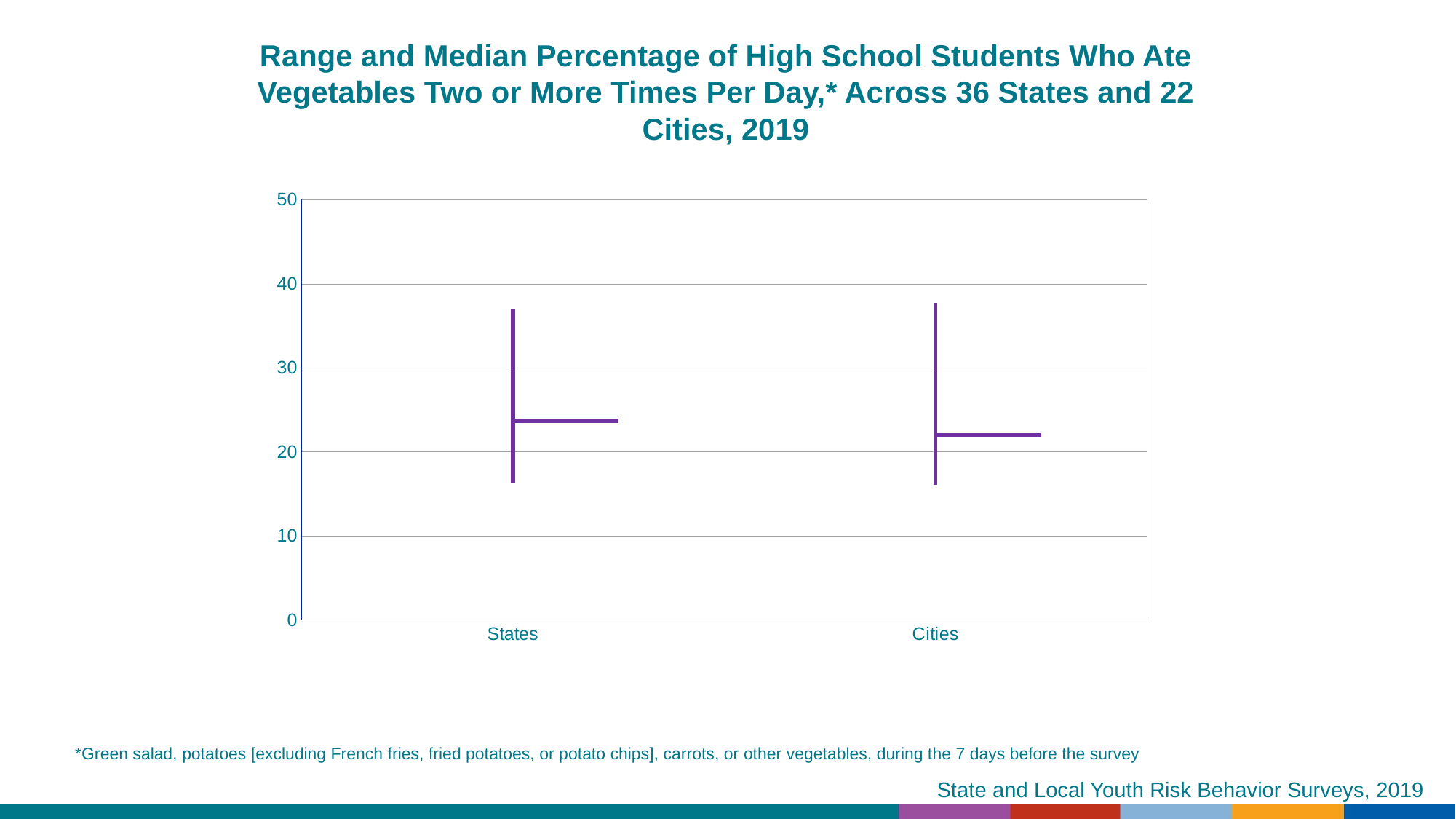
Which has the higher median value, States or Cities? States Is the median value for States greater or less than 30? less Is the top of the range for States greater or less than 30? greater Is the bottom of the range for States greater or less than 20? less What are the two categories shown on the x axis? States and Cities What year does the chart title refer to? 2019 What is the highest value shown on the y axis? 50 How many categories are shown on the x axis of the chart? 2